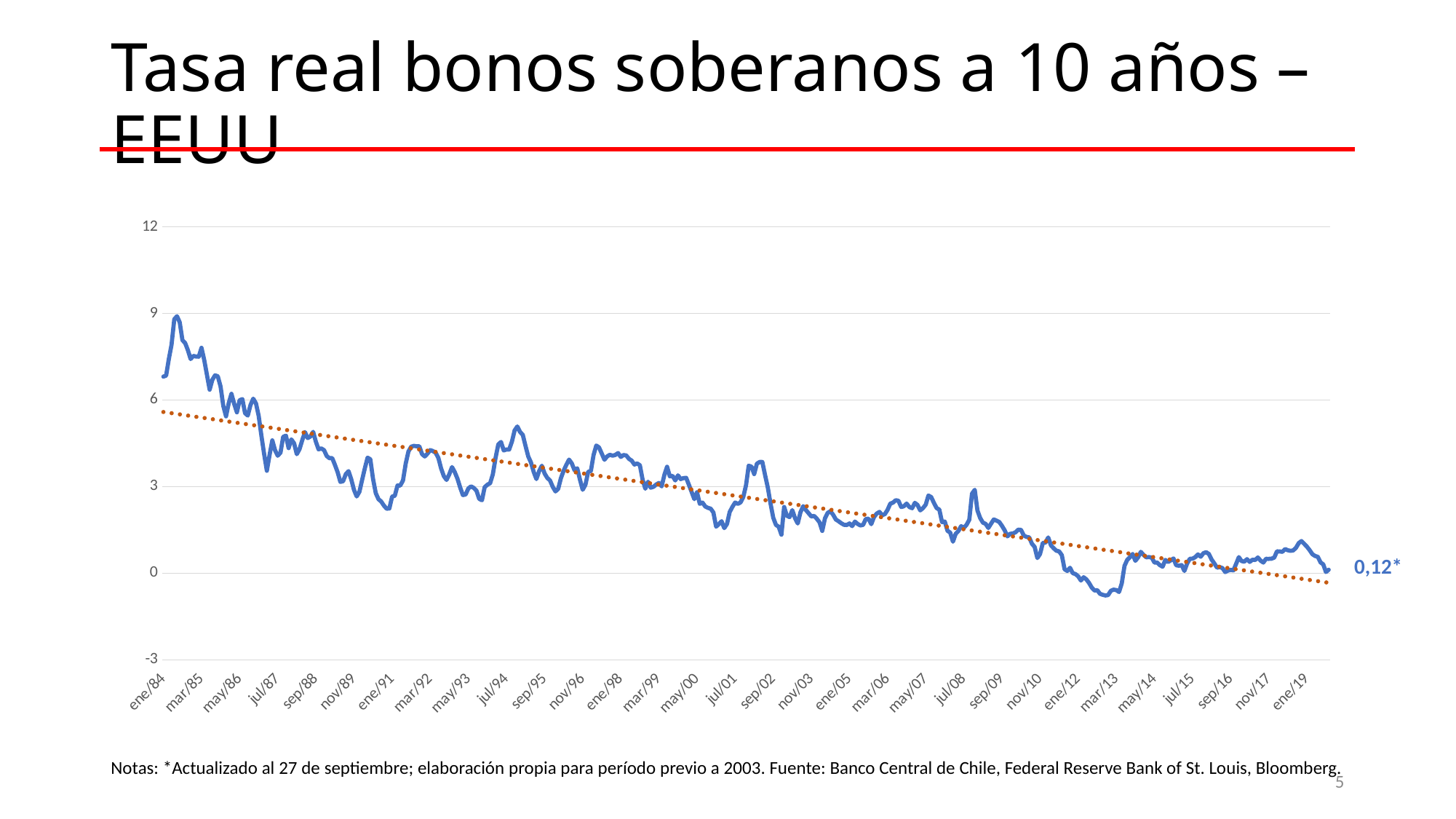
Near which labeled date on the x axis does the line reach its lowest value? mar/13 Is the value at ene/84 greater or less than 6? greater What is the title of the chart on the slide? Tasa real bonos soberanos a 10 años – EEUU Is the value around jul/94 greater or less than 3? greater Does the real rate generally rise or fall from ene/84 to ene/19? fall What is the highest tick value shown on the y axis? 12 Near which labeled date on the x axis does the line reach its highest value? ene/84 What is the value shown by the data label at the end of the line? 0,12* Is the value around nov/03 greater or less than 3? less What kind of chart is shown on the slide? line chart Which is larger, the value at ene/84 or the value at ene/19? ene/84